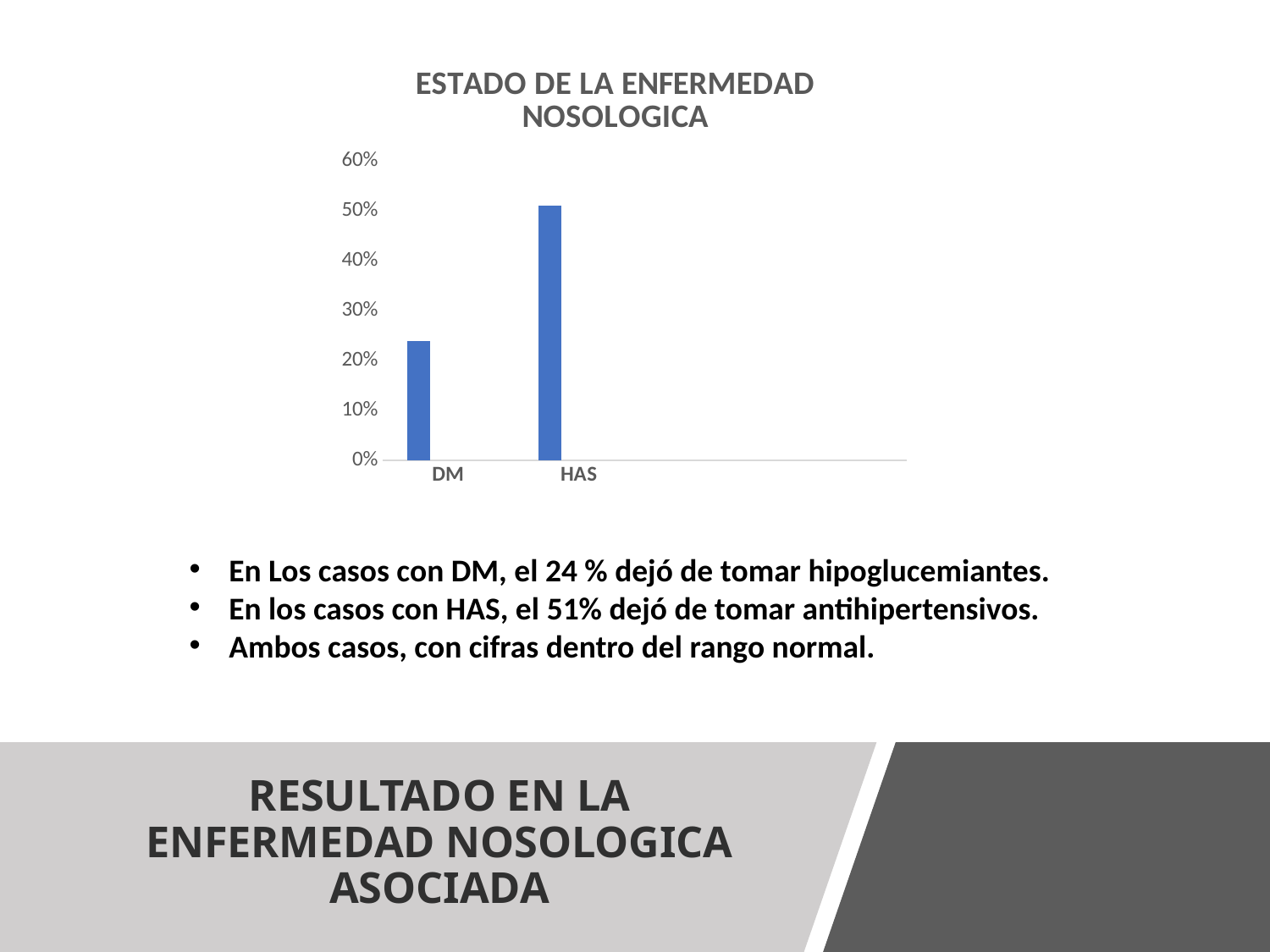
Which category has the lowest value in the chart? DM What is the highest value shown on the vertical axis of the chart? 60% Is the value for DM greater or less than 20%? greater Which is larger, the value for DM or the value for HAS? HAS How many categories are plotted in the chart? 2 Is the value for DM greater or less than 30%? less What type of chart is shown on the slide? bar chart According to the slide, what percentage of DM cases stopped taking hypoglycemic drugs? 24 % What is the title of the chart? ESTADO DE LA ENFERMEDAD NOSOLOGICA According to the slide, what percentage of HAS cases stopped taking antihypertensives? 51% Which category has the highest value in the chart? HAS Is the value for HAS greater or less than 50%? greater